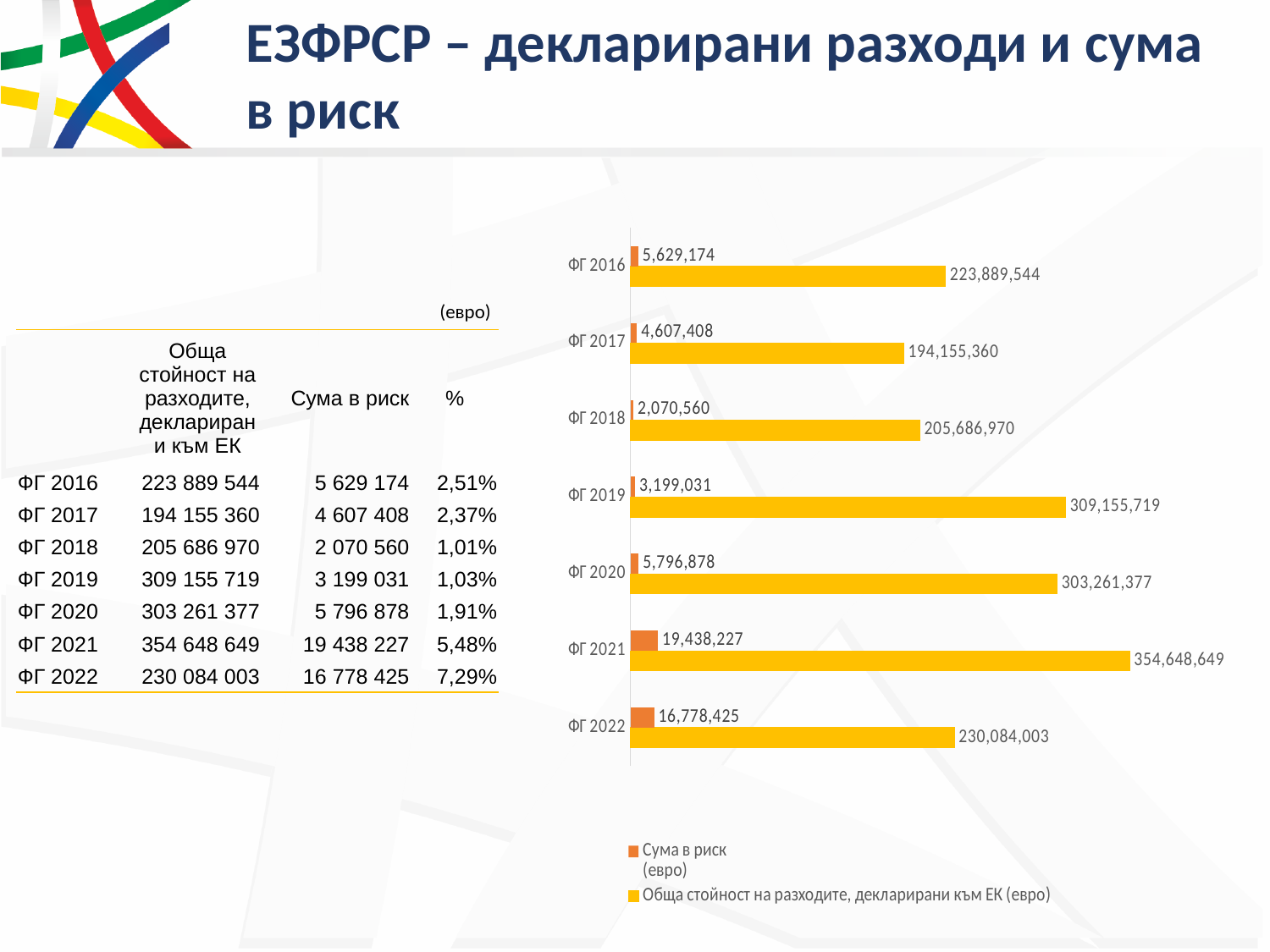
Which year has the lowest Сума в риск (евро) in the chart? ФГ 2018 What is the difference between the Обща стойност на разходите, декларирани към ЕК (евро) for ФГ 2021 and ФГ 2022 in the chart? 124,564,646 Which year has the lowest Обща стойност на разходите, декларирани към ЕК (евро) in the chart? ФГ 2017 What is the value of Обща стойност на разходите, декларирани към ЕК (евро) for ФГ 2019 in the chart? 309,155,719 What is the difference between the Сума в риск (евро) for ФГ 2021 and ФГ 2022 in the chart? 2,659,802 How many years (categories) are shown in the chart? 7 How many series does the chart legend list? 2 Which is larger in the chart: the Сума в риск (евро) for ФГ 2021 or for ФГ 2022? ФГ 2021 What is the value of Сума в риск (евро) for ФГ 2017 in the chart? 4,607,408 What type of chart is shown on the slide? Bar chart What is the value of Сума в риск (евро) for ФГ 2021 in the chart? 19,438,227 Which year has the highest Обща стойност на разходите, декларирани към ЕК (евро) in the chart? ФГ 2021